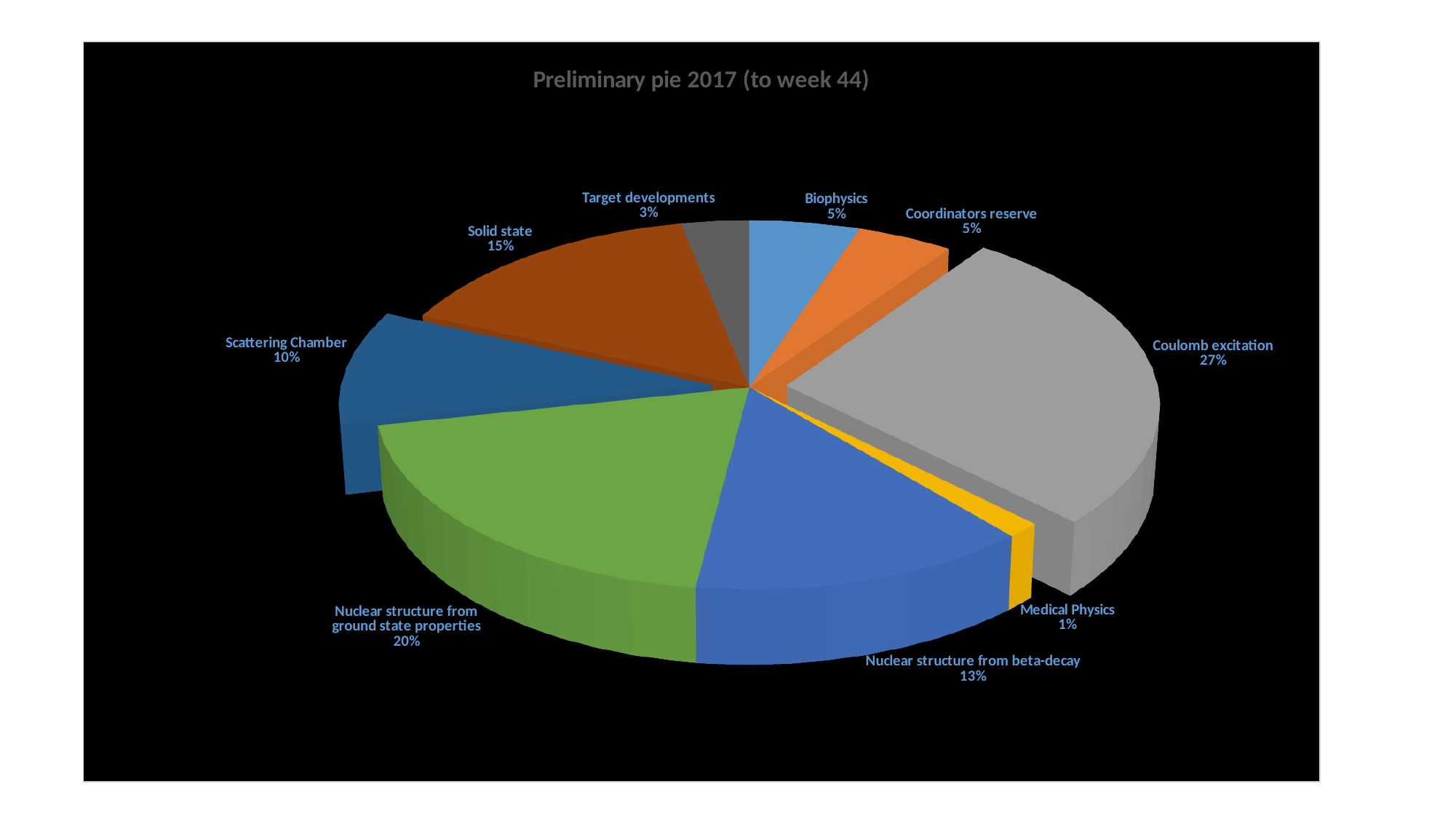
Which category has the largest slice of the pie? Coulomb excitation What kind of chart is shown on the slide? Pie chart Which category has the smallest slice of the pie? Medical Physics What percentage is shown for Target developments? 3% What is the value shown for Nuclear structure from ground state properties? 20% Which is larger, Solid state or Scattering Chamber? Solid state What share of the pie does Coulomb excitation have? 27% What is the title of the chart? Preliminary pie 2017 (to week 44) What is the combined share of Biophysics and Coordinators reserve? 10% What percentage is shown for Scattering Chamber? 10% What is the difference in percentage points between Solid state and Nuclear structure from beta-decay? 2 How many categories are shown in the pie chart? 9